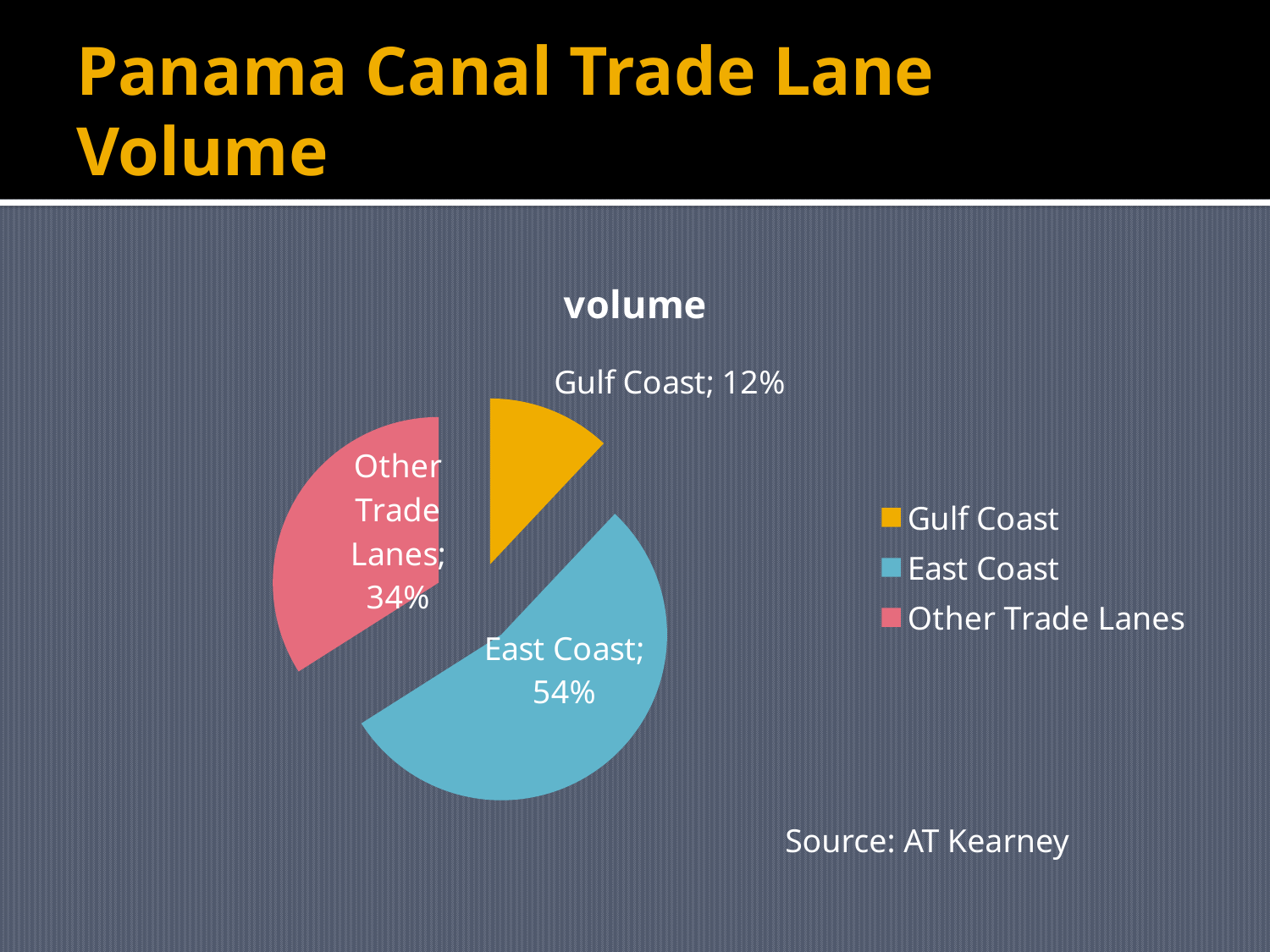
What colour is the East Coast slice? blue What is the difference in percentage points between East Coast and Gulf Coast? 42 What is the title of the chart? volume What share of the pie does Other Trade Lanes represent? 34% What is the difference in percentage points between Other Trade Lanes and Gulf Coast? 22 How many slices does the pie chart have? 3 What kind of chart is shown on the slide? pie chart What share of the pie does Gulf Coast represent? 12% What share of the pie does East Coast represent? 54% Which category has the largest share of the pie? East Coast Which category has the smallest share of the pie? Gulf Coast Which is larger, the share for Other Trade Lanes or the share for Gulf Coast? Other Trade Lanes